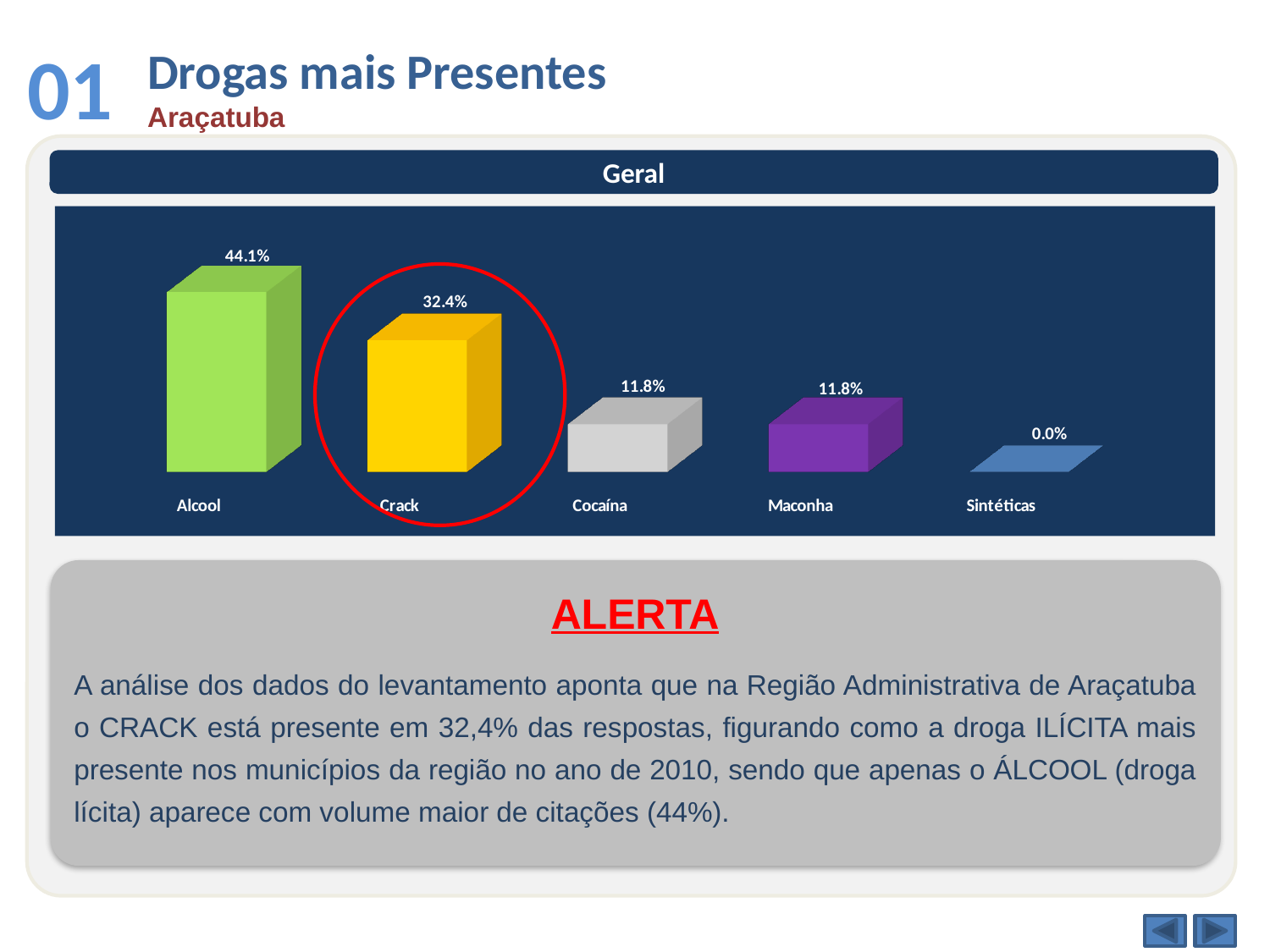
What is the value for Sintéticas? 0.0% Which category has the lowest value? Sintéticas Which is larger, the value for Crack or the value for Maconha? Crack What is the value for Crack? 32.4% Which category is circled in red on the chart? Crack What is the difference between the values for Alcool and Crack? 11.7% What kind of chart is shown on the slide? Bar chart Which category has the highest value? Alcool What is the difference between the values for Crack and Cocaína? 20.6% What is the value for Cocaína? 11.8% What is the value for Alcool? 44.1% How many categories are shown in the chart? 5